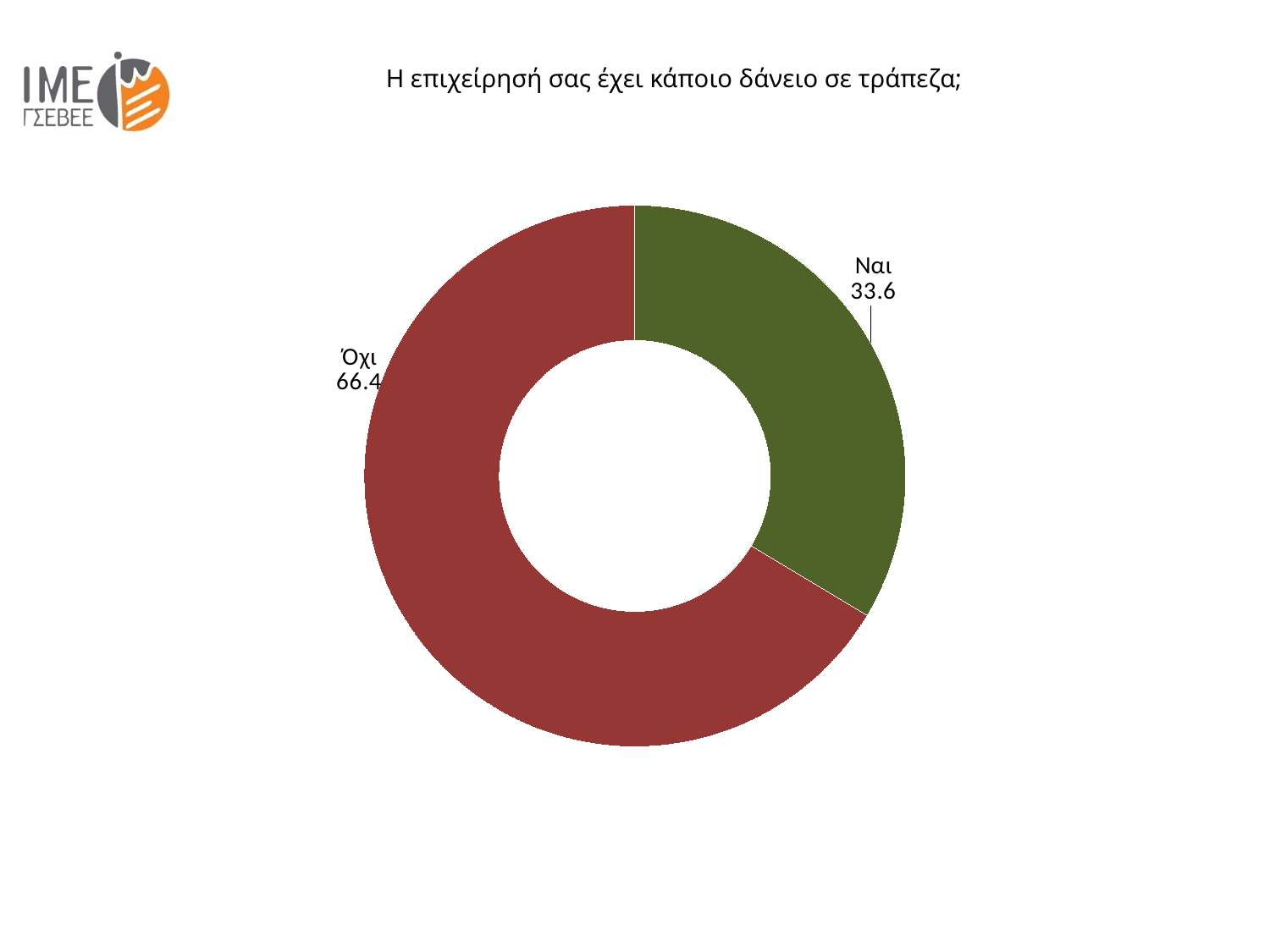
What colour is the Ναι segment? Green Which is larger, the value for Ναι or the value for Όχι? Όχι What kind of chart is shown on the slide? Doughnut chart What is the difference between the values for Όχι and Ναι? 32.8 What is the title of the chart? Η επιχείρησή σας έχει κάποιο δάνειο σε τράπεζα; How many categories are shown in the chart? 2 Which category has the smallest share? Ναι What is the value for Ναι? 33.6 What is the value for Όχι? 66.4 Which category has the largest share? Όχι What is the total of the two values shown in the chart? 100